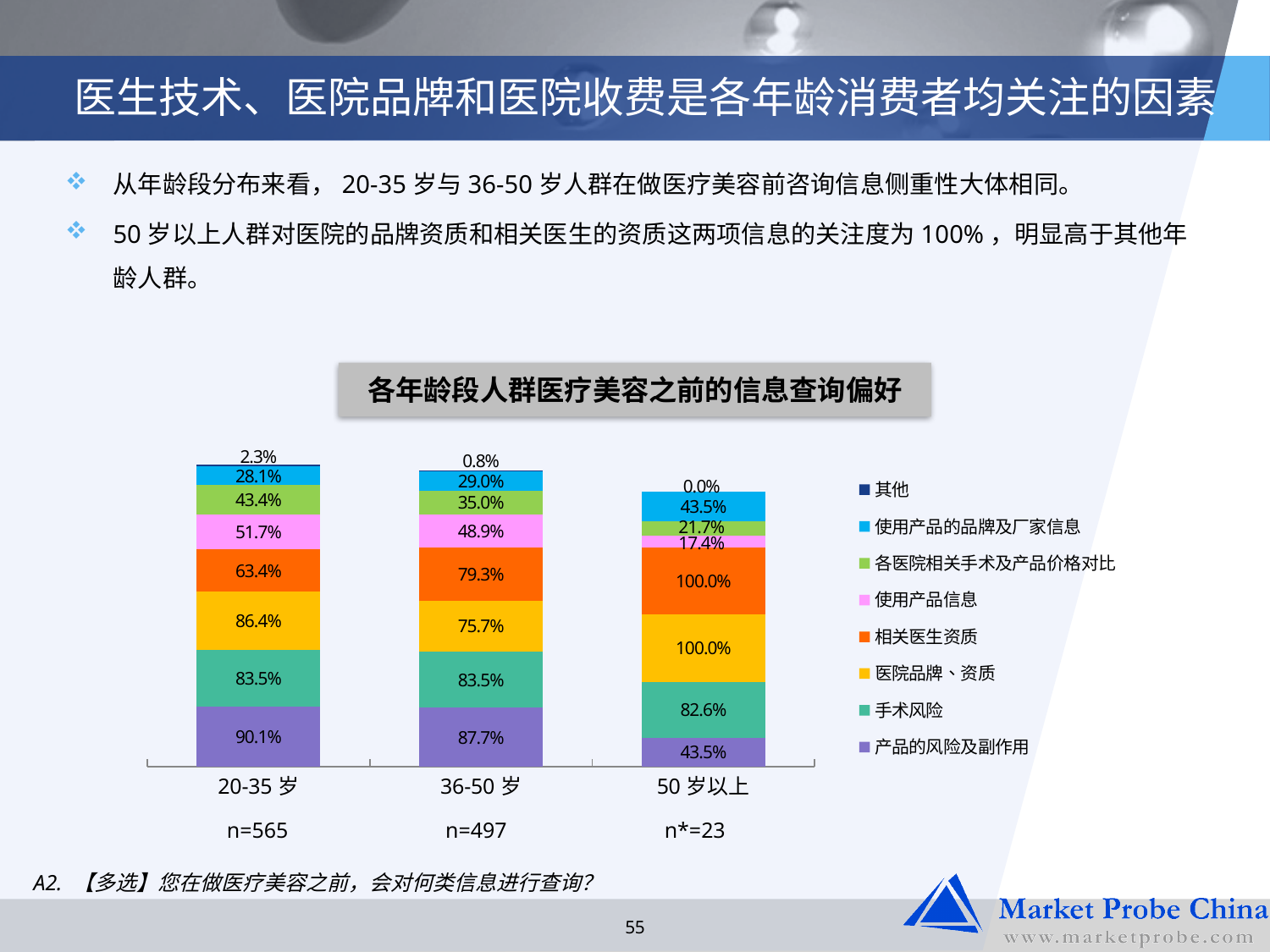
Which age group has the lowest value for 使用产品信息? 50 岁以上 What type of chart is shown on the slide? Stacked bar chart Which is larger: the 手术风险 value for 36-50 岁 or the 手术风险 value for 50 岁以上? 36-50 岁 What is the value for 产品的风险及副作用 in the 20-35 岁 group? 90.1% What is the value for 相关医生资质 in the 36-50 岁 group? 79.3% What is the title of the chart? 各年龄段人群医疗美容之前的信息查询偏好 What is the difference between the 医院品牌、资质 values for the 20-35 岁 and 36-50 岁 groups? 10.7% What is the value for 医院品牌、资质 in the 50 岁以上 group? 100.0% What is the value for 其他 in the 36-50 岁 group? 0.8% Which age group has the highest value for 使用产品的品牌及厂家信息? 50 岁以上 How many age groups (categories) are shown on the x axis of the chart? 3 How many series does the chart legend list? 8